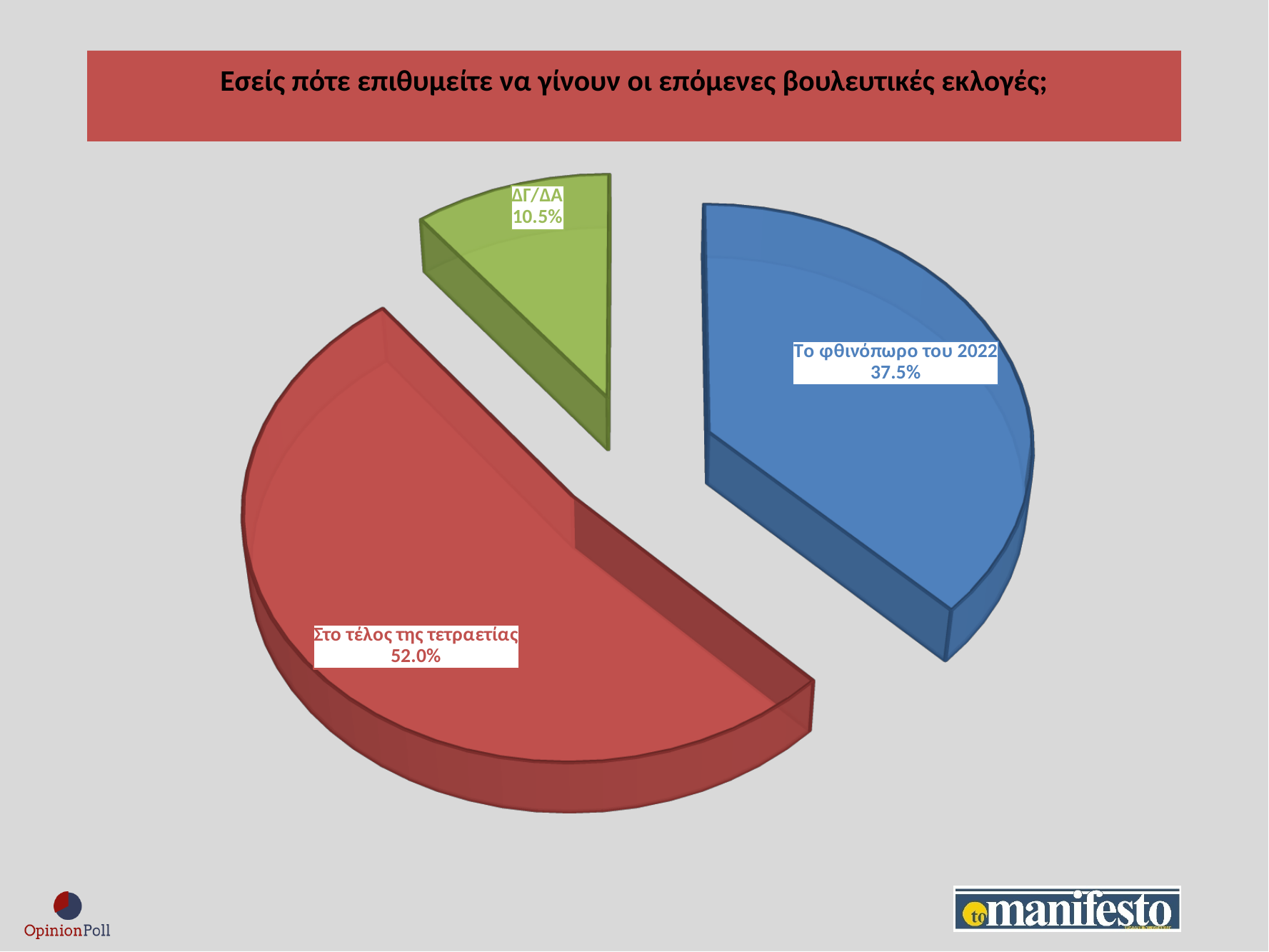
What is the value for "Το φθινόπωρο του 2022"? 37.5% What is the value for "ΔΓ/ΔΑ"? 10.5% What colour is the slice for "Το φθινόπωρο του 2022"? Blue Which category has the largest share of the pie? Στο τέλος της τετραετίας What is the difference between the values for "Στο τέλος της τετραετίας" and "Το φθινόπωρο του 2022"? 14.5% What is the difference between the values for "Το φθινόπωρο του 2022" and "ΔΓ/ΔΑ"? 27.0% What is the title of the chart? Εσείς πότε επιθυμείτε να γίνουν οι επόμενες βουλευτικές εκλογές; What type of chart is shown on the slide? Pie chart Which is larger: the value for "Το φθινόπωρο του 2022" or the value for "ΔΓ/ΔΑ"? Το φθινόπωρο του 2022 What is the value for "Στο τέλος της τετραετίας"? 52.0% How many slices does the pie chart have? 3 Which category has the smallest share of the pie? ΔΓ/ΔΑ